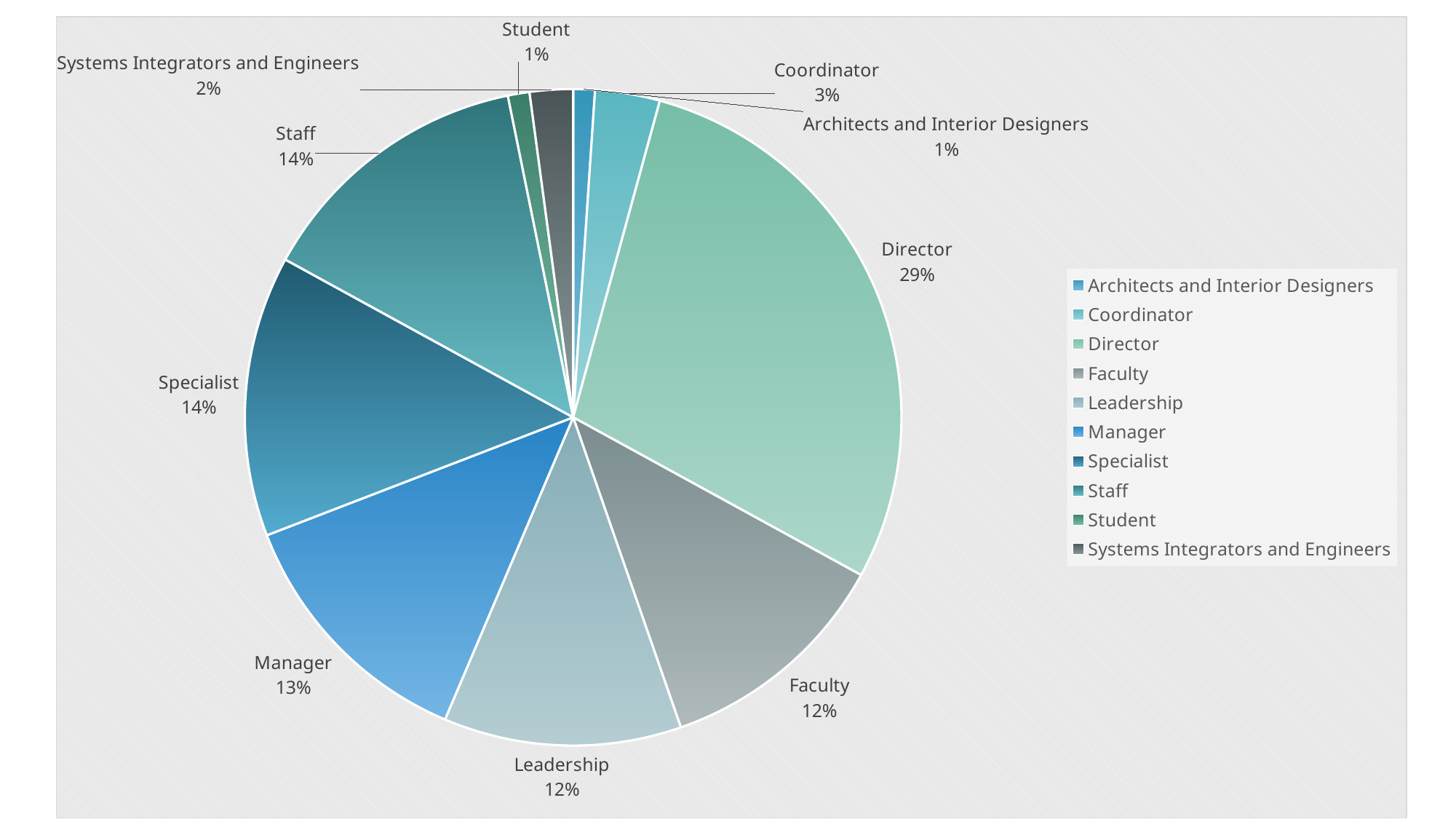
What is the value shown for Leadership? 12% What kind of chart is shown on the slide? pie chart Which is larger, the Staff slice or the Manager slice? Staff How many categories does the legend list? 10 What share of the pie does Director represent? 29% What is the value shown for Manager? 13% What is the value shown for Systems Integrators and Engineers? 2% What is the difference between the Director share and the Faculty share? 17% What is the difference between the Specialist share and the Coordinator share? 11% What is the value shown for Coordinator? 3% Which legend entry is listed last? Systems Integrators and Engineers Which category has the largest slice of the pie? Director